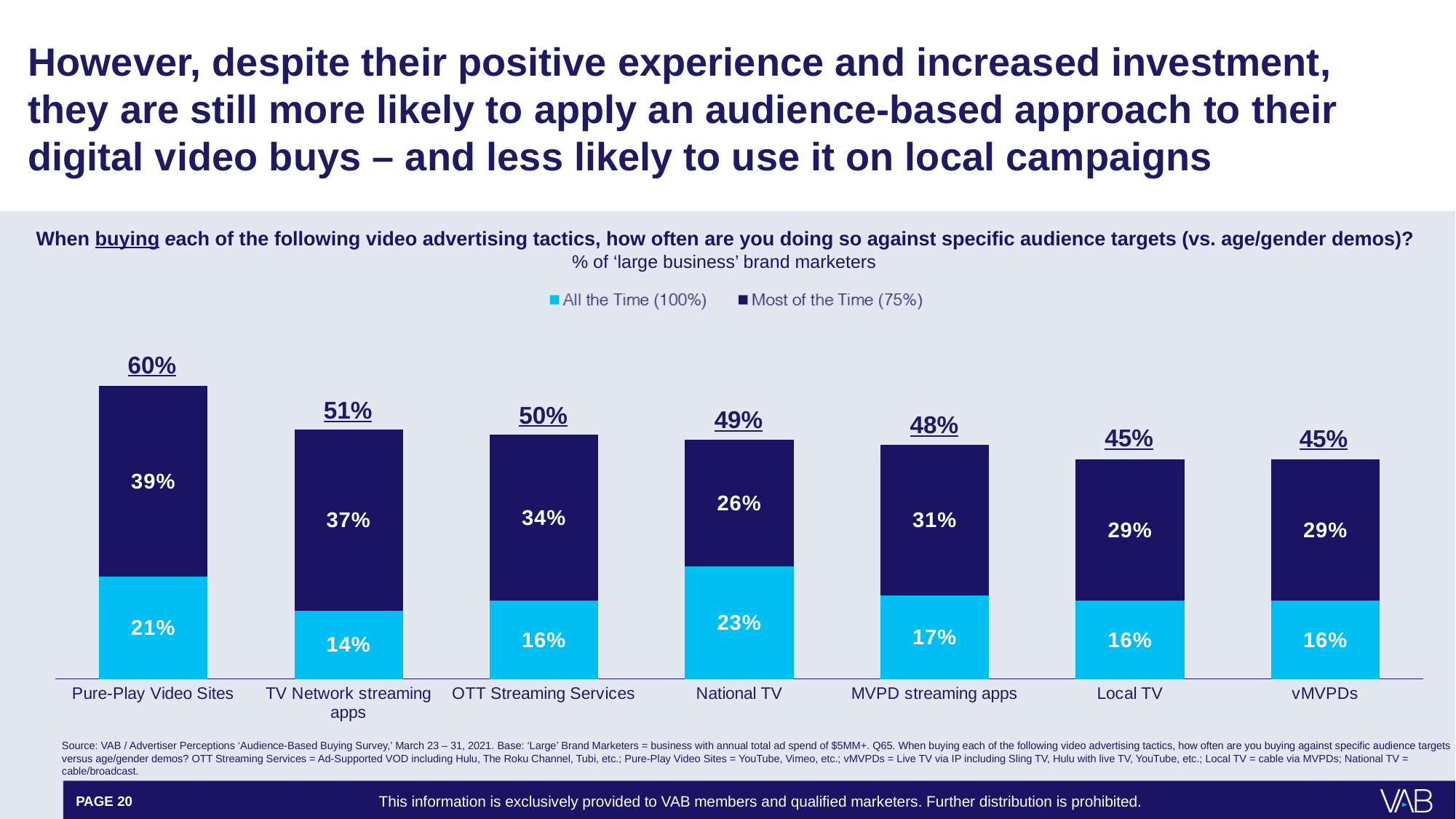
Which series is shown in light blue in the legend? All the Time (100%) What is the 'All the Time (100%)' value for MVPD streaming apps? 17% What is the 'Most of the Time (75%)' value for National TV? 26% How many categories are shown on the x axis? 7 Which is larger: the 'All the Time (100%)' value for National TV or for OTT Streaming Services? National TV What is the 'All the Time (100%)' value for Pure-Play Video Sites? 21% What kind of chart is shown on the slide? Stacked bar chart What is the difference between the 'Most of the Time (75%)' values for Pure-Play Video Sites and Local TV? 10% Which category has the lowest 'All the Time (100%)' value? TV Network streaming apps What is the total shown above the bar for OTT Streaming Services? 50% How many series does the legend list? 2 Which category has the highest total bar? Pure-Play Video Sites